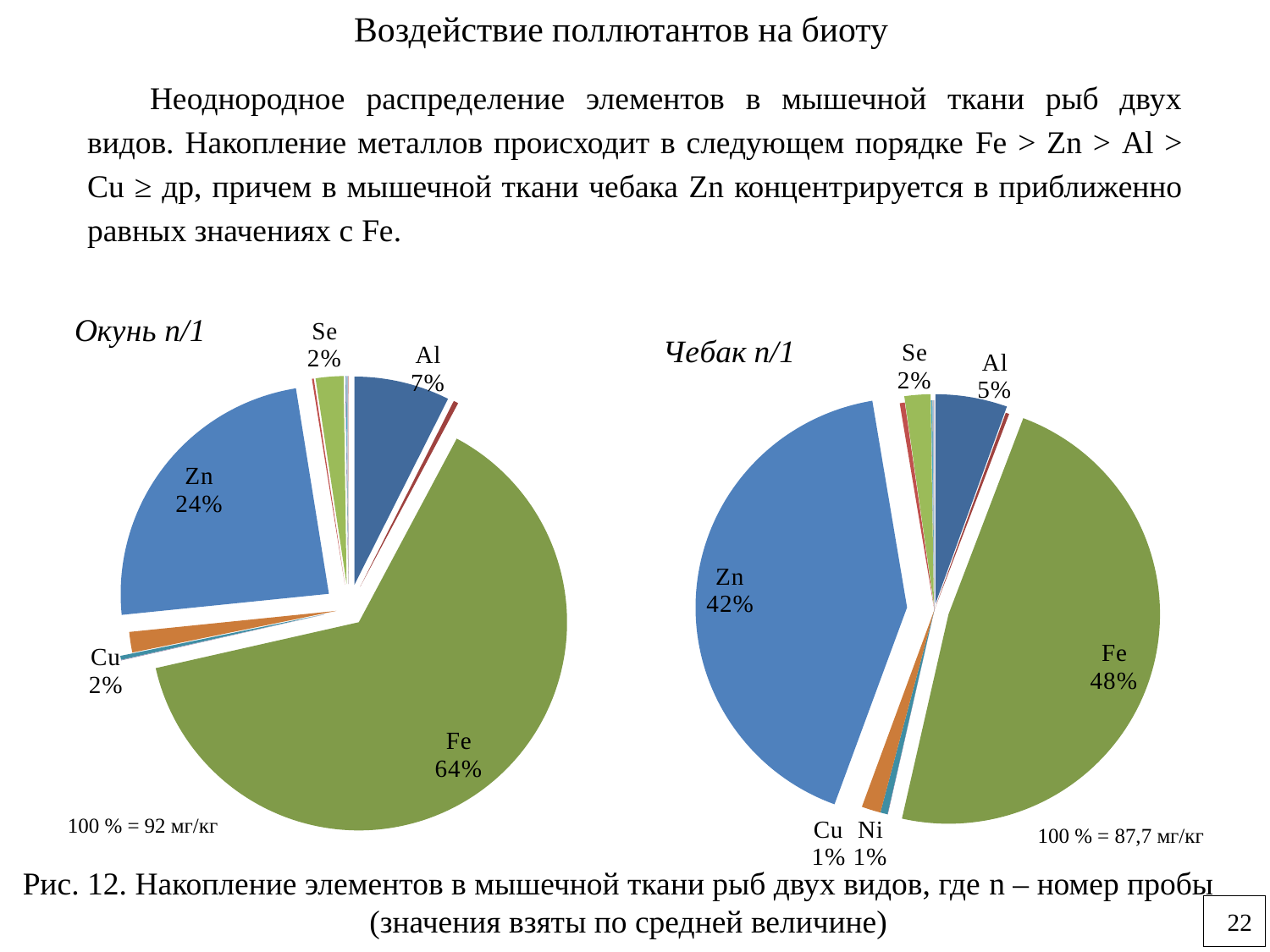
In the Окунь n/1 pie chart, what share does Al have? 7% In the Чебак n/1 pie chart, what is the difference in percentage points between the Fe share and the Zn share? 6 percentage points In the Чебак n/1 pie chart, what share does Fe have? 48% In the Чебак n/1 pie chart, what share does Zn have? 42% In the Чебак n/1 pie chart, which element has the largest share? Fe In the Окунь n/1 pie chart, what share does Zn have? 24% Which chart shows a larger share for Zn, Окунь n/1 or Чебак n/1? Чебак n/1 In the Окунь n/1 pie chart, which element has the largest share? Fe In the Окунь n/1 pie chart, what share does Fe have? 64% In the Чебак n/1 pie chart, what share does Al have? 5% In the Окунь n/1 pie chart, what is the difference in percentage points between the Fe share and the Zn share? 40 percentage points What type of chart is used for Окунь n/1 and Чебак n/1? Pie chart